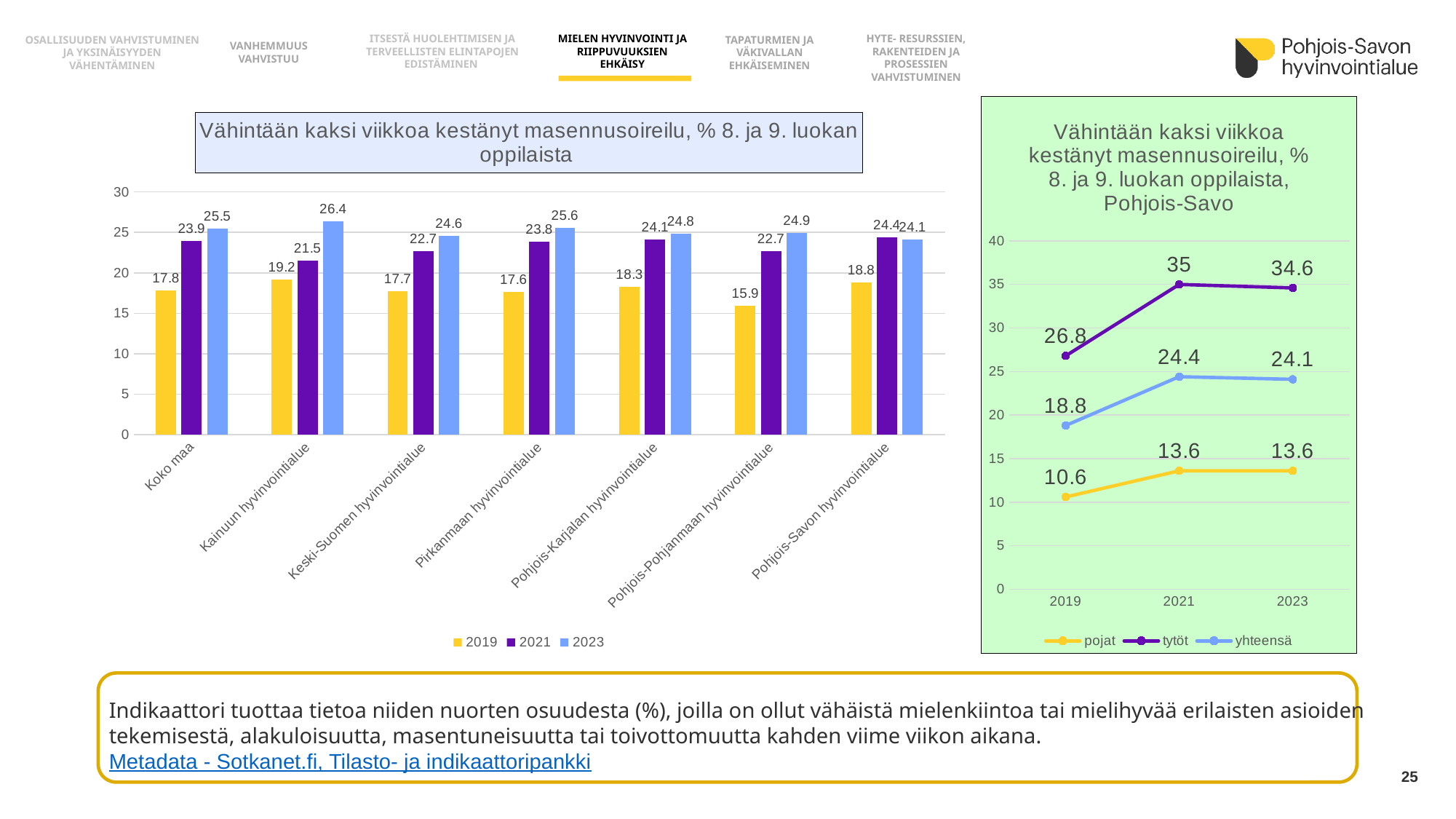
In the right line chart, does the pojat series rise or fall from 2019 to 2021? Rise In the right line chart, what is the value for tytöt in 2021? 35 In the left bar chart, which category has the lowest 2019 value? Pohjois-Pohjanmaan hyvinvointialue In the left bar chart, which category has the highest 2023 value? Kainuun hyvinvointialue How many series does the legend of the left bar chart list? 3 In the right line chart, what is the difference between the tytöt and pojat values in 2023? 21 How many categories are shown on the x axis of the left bar chart? 7 In the left bar chart, what is the 2023 value for Kainuun hyvinvointialue? 26.4 In the left bar chart, which is larger for Pohjois-Savon hyvinvointialue: the 2021 value or the 2023 value? 2021 What kind of chart is the chart on the right side of the slide? Line chart In the left bar chart, what is the difference between the 2023 and 2019 values for Koko maa? 7.7 In the left bar chart, what is the 2019 value for Pohjois-Pohjanmaan hyvinvointialue? 15.9